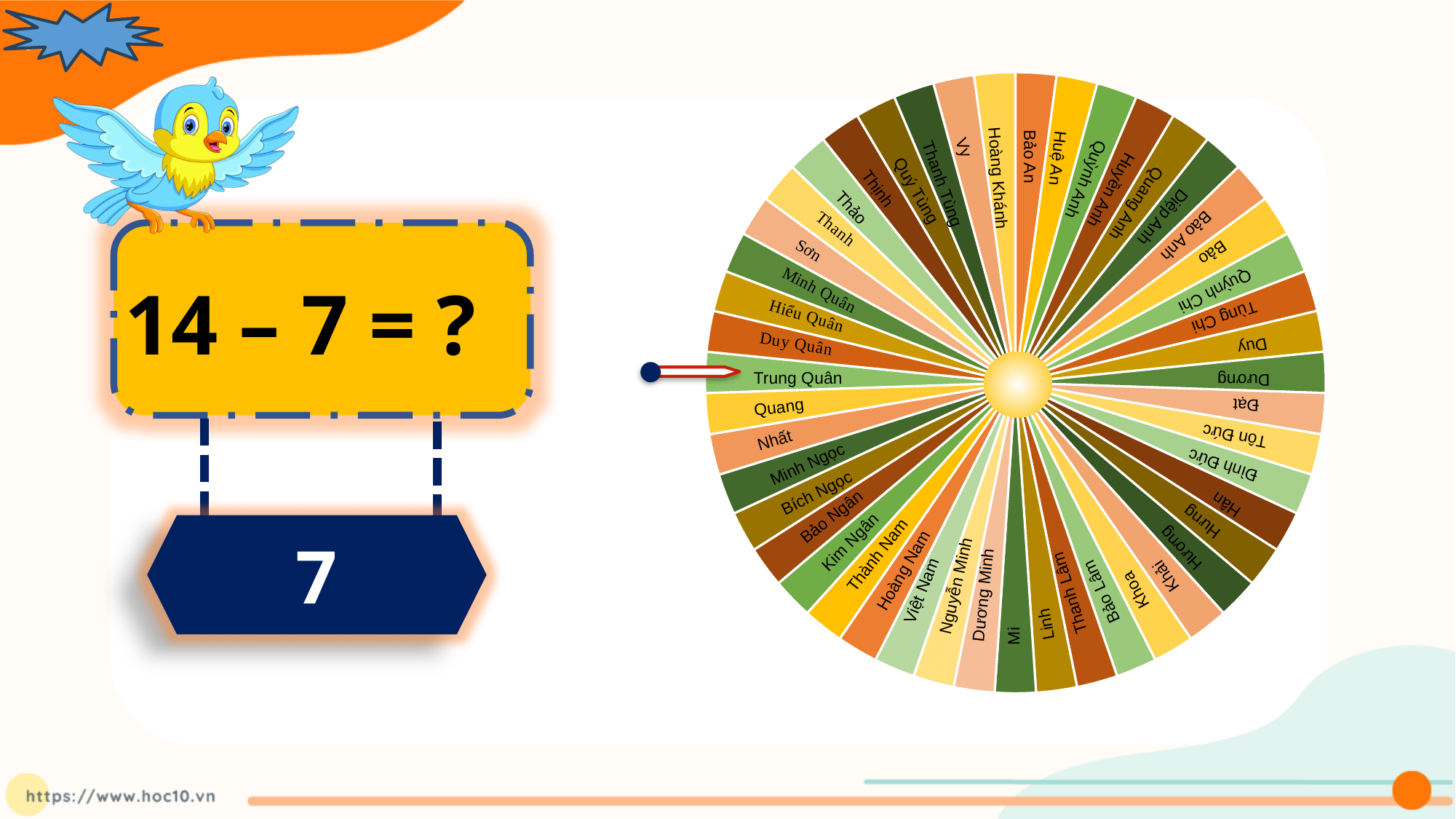
Which name on the wheel does the arrow pointer on the left point to? Trung Quân Which name is in the slice directly below the slice labelled Trung Quân on the wheel? Quang What kind of chart is the wheel on the right side of the slide? pie chart Which name appears in the slice at the very top of the wheel, just right of the 12 o'clock position? Bảo An Which name appears in the slice at the very bottom of the wheel, just left of the 6 o'clock position? Dương Minh Are the slices of the wheel all the same size, or do they differ in size? the same size Does the wheel chart show any numeric data labels on its slices? No Which name is in the slice directly above the slice labelled Trung Quân on the wheel? Duy Quân